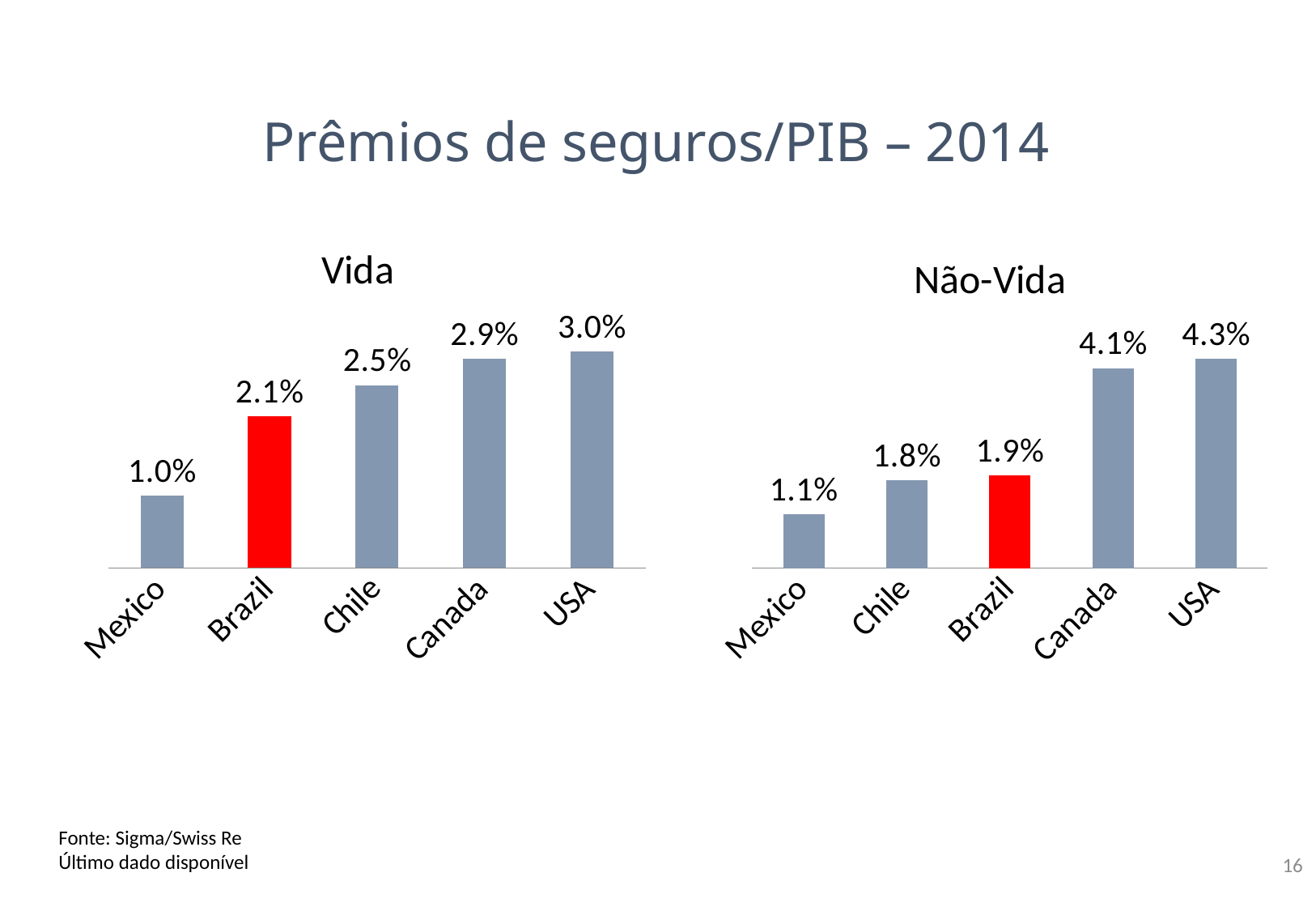
In the "Não-Vida" chart, what is the difference between the values for USA and Brazil? 2.4% In the "Vida" chart, what is the difference between the values for USA and Mexico? 2.0% In the "Vida" chart, do the values rise or fall from left to right? Rise What kind of chart is the "Não-Vida" chart? Bar chart In the "Vida" chart, which country's bar is coloured red? Brazil In the "Vida" chart, which country has the highest value? USA In the "Vida" chart, how many countries are shown? 5 In the "Não-Vida" chart, which country has the lowest value? Mexico In the "Não-Vida" chart, what is the value for Canada? 4.1% In the "Vida" chart, what is the value for Brazil? 2.1% What is the title of the slide? Prêmios de seguros/PIB – 2014 In the "Não-Vida" chart, which is larger, the value for Chile or the value for Canada? Canada